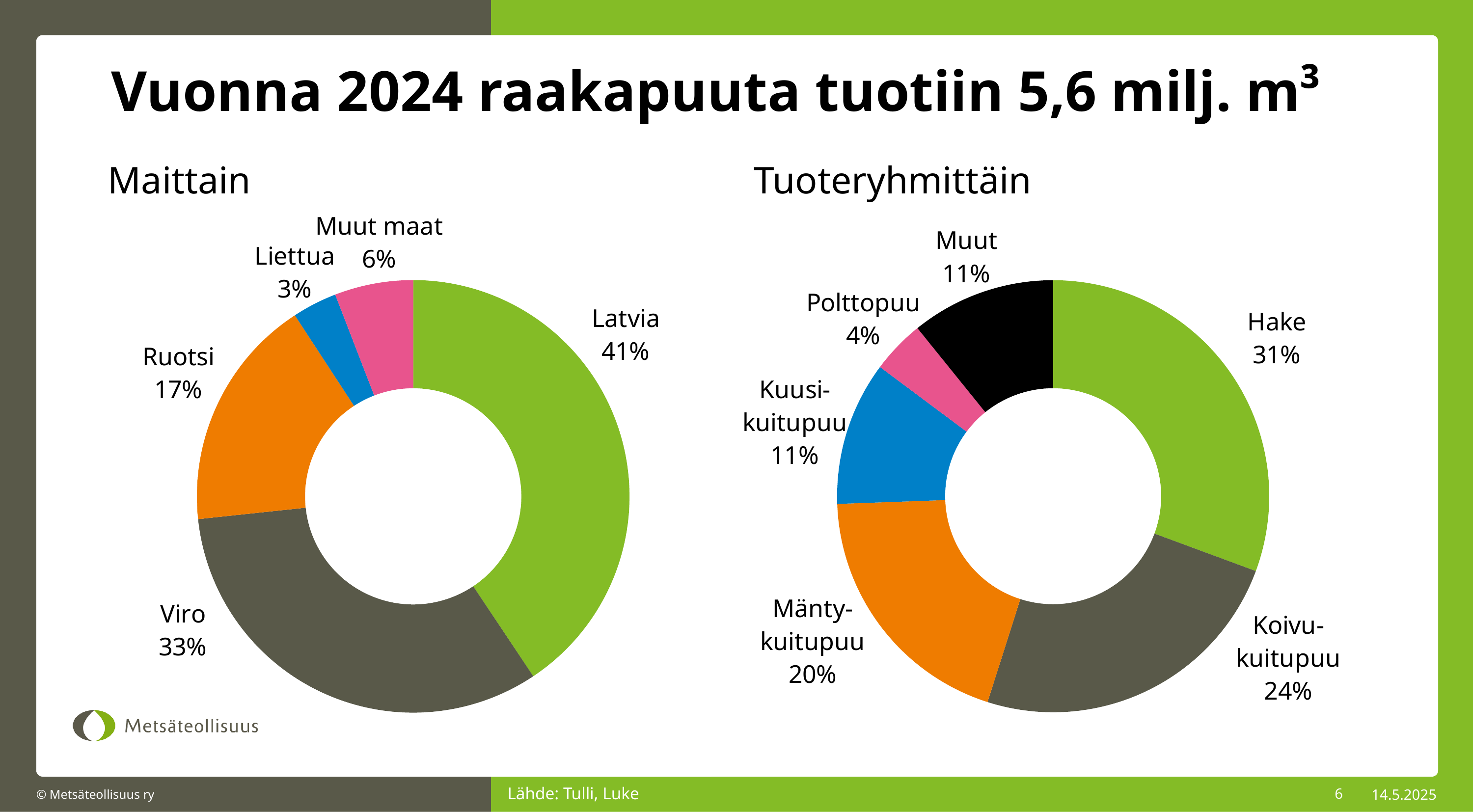
In the 'Tuoteryhmittäin' chart, which product group has the smallest share? Polttopuu In the 'Maittain' chart, what is the difference in percentage points between Latvia and Viro? 8 In the 'Maittain' chart, how many slices are there? 5 In the 'Maittain' chart, what share does Latvia have? 41% In the 'Tuoteryhmittäin' chart, what share does Hake have? 31% In the 'Tuoteryhmittäin' chart, which is larger, Koivu-kuitupuu or Mänty-kuitupuu? Koivu-kuitupuu In the 'Tuoteryhmittäin' chart, what share does Mänty-kuitupuu have? 20% In the 'Tuoteryhmittäin' chart, how many slices are there? 6 In the 'Maittain' chart, which country has the largest share? Latvia In the 'Maittain' chart, what share does Ruotsi have? 17% What type of chart is the 'Maittain' chart? Pie (doughnut) chart In the 'Maittain' chart, which country has the smallest share? Liettua